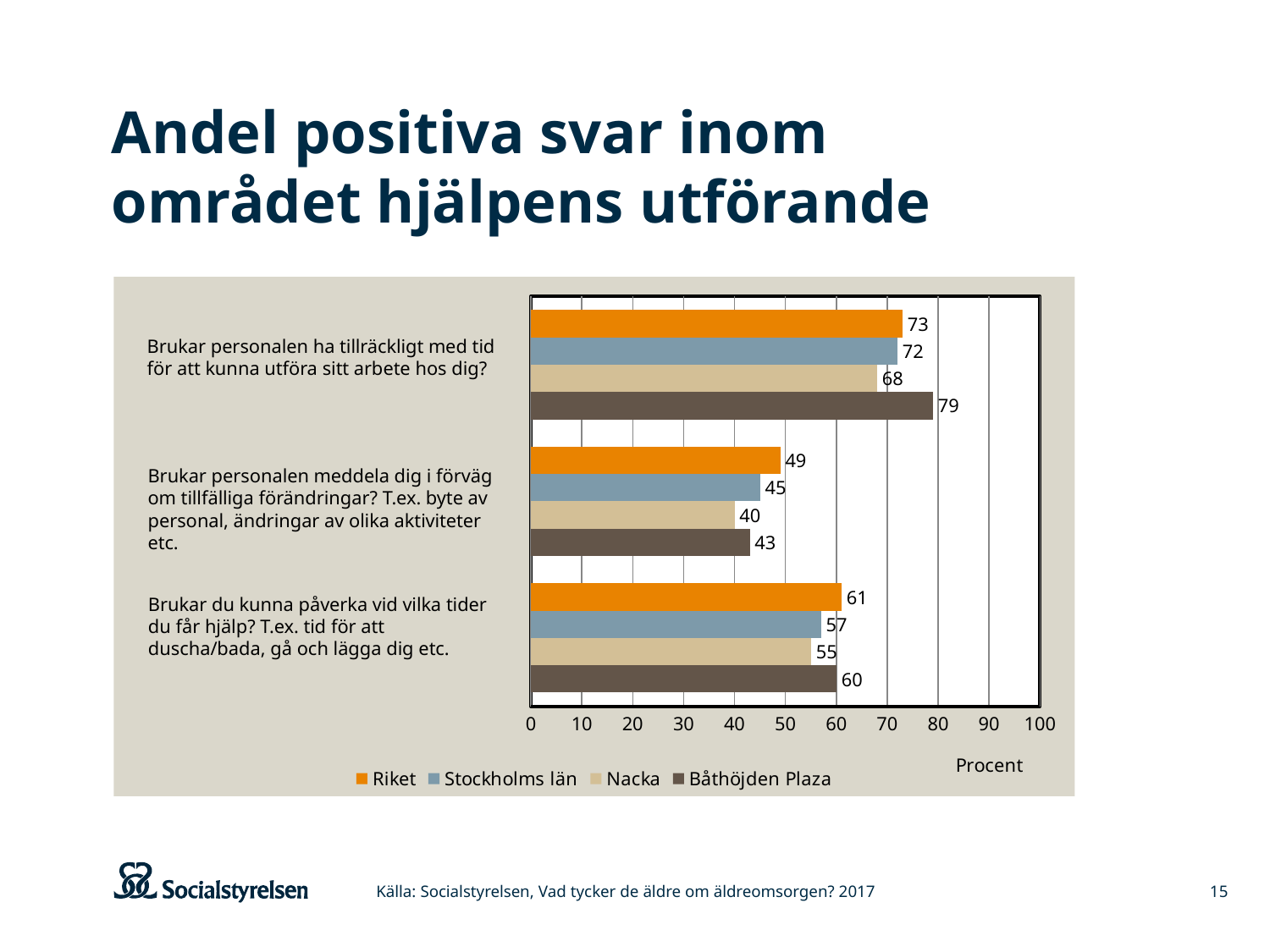
What unit label is shown on the horizontal axis? Procent What is the value for Nacka on the question "Brukar personalen meddela dig i förväg om tillfälliga förändringar?"? 40 How many series does the legend list? 4 Which is larger on the question "Brukar du kunna påverka vid vilka tider du får hjälp?": Riket or Båthöjden Plaza? Riket Which series has the lowest value on the question "Brukar personalen meddela dig i förväg om tillfälliga förändringar?"? Nacka What is the value for Båthöjden Plaza on the question "Brukar personalen ha tillräckligt med tid för att kunna utföra sitt arbete hos dig?"? 79 What is the value for Riket on the question "Brukar du kunna påverka vid vilka tider du får hjälp?"? 61 What is the difference between the Båthöjden Plaza and Nacka values on the question "Brukar personalen ha tillräckligt med tid för att kunna utföra sitt arbete hos dig?"? 11 Which series has the highest value on the question "Brukar personalen ha tillräckligt med tid för att kunna utföra sitt arbete hos dig?"? Båthöjden Plaza What kind of chart is shown on the slide? Bar chart What is the value for Stockholms län on the question "Brukar personalen ha tillräckligt med tid för att kunna utföra sitt arbete hos dig?"? 72 How many questions (categories) are shown on the chart? 3